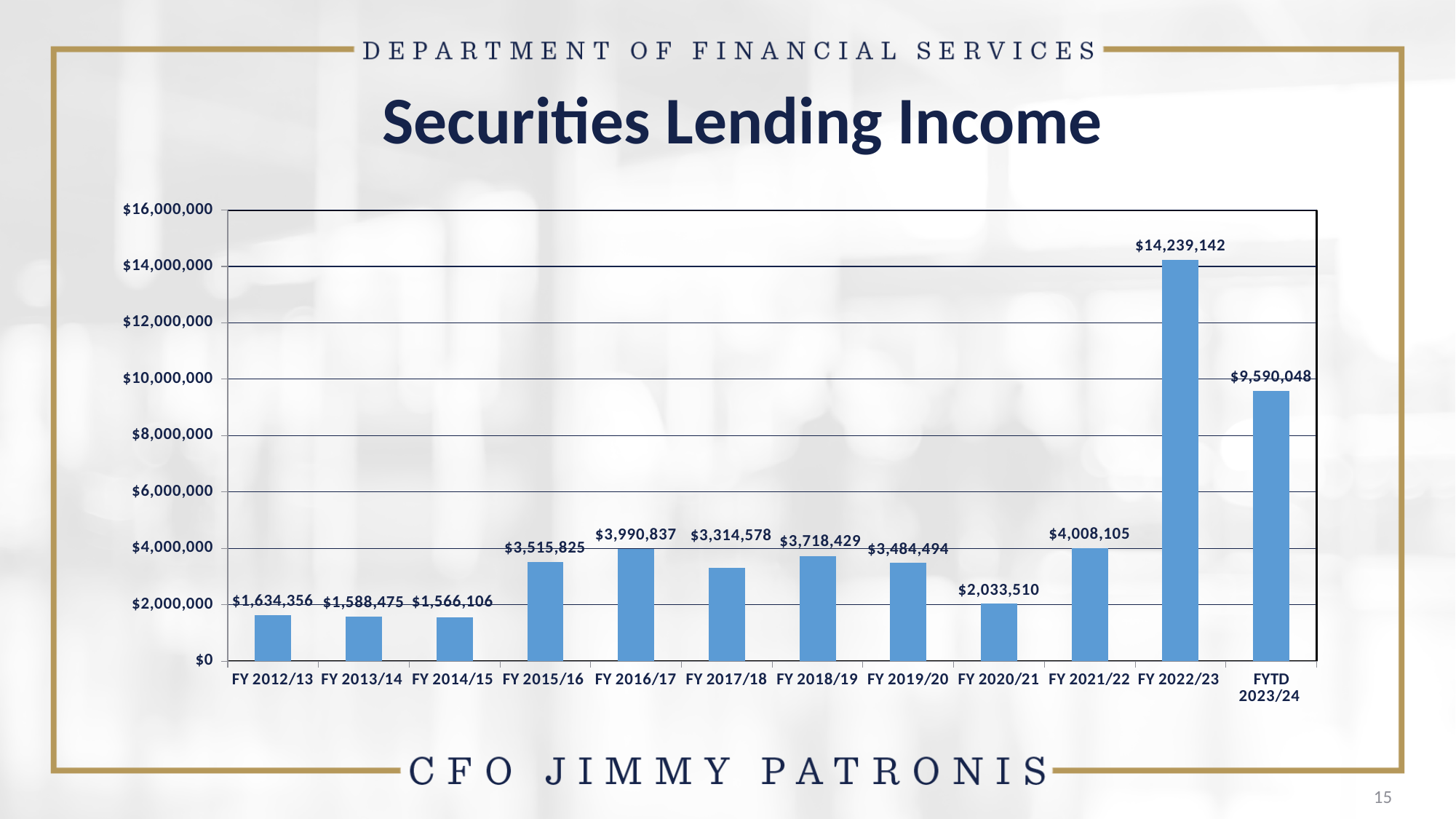
How many fiscal years are shown on the chart? 12 What is the securities lending income for FY 2022/23? $14,239,142 What kind of chart is shown on the slide? Bar chart Which fiscal year has the lowest securities lending income? FY 2014/15 What is the difference between the securities lending income for FY 2022/23 and FYTD 2023/24? $4,649,094 Which is larger, the securities lending income for FY 2018/19 or FY 2017/18? FY 2018/19 What is the securities lending income for FYTD 2023/24? $9,590,048 What is the securities lending income for FY 2020/21? $2,033,510 What is the difference between the securities lending income for FY 2021/22 and FY 2020/21? $1,974,595 Is the value for FY 2015/16 greater or less than $4,000,000? less Which fiscal year has the highest securities lending income? FY 2022/23 What is the securities lending income for FY 2016/17? $3,990,837